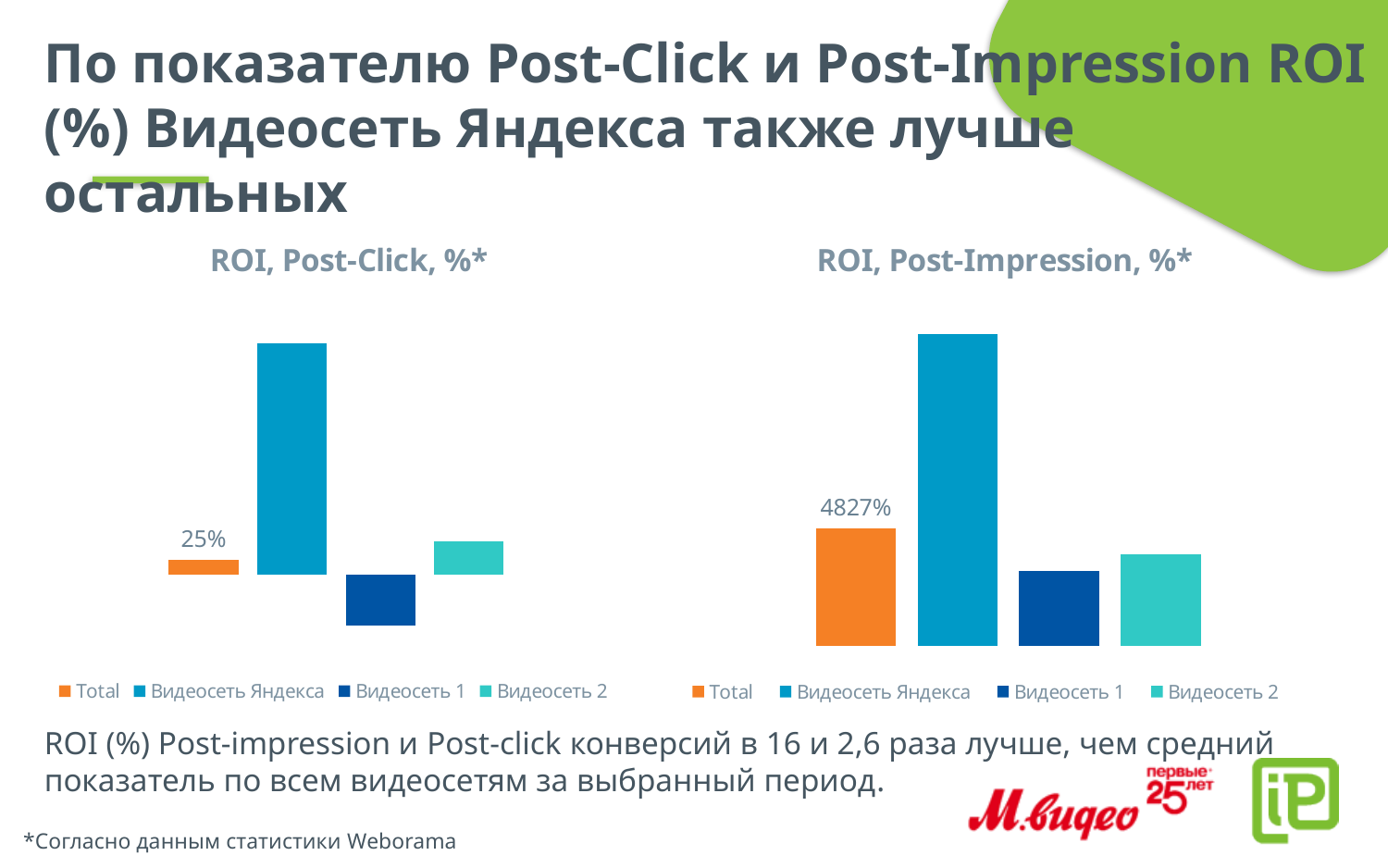
How many bars are plotted in the 'ROI, Post-Impression, %*' chart? 4 In the 'ROI, Post-Click, %*' chart, what is the value for Total? 25% In the 'ROI, Post-Impression, %*' chart, which is larger: Видеосеть 1 or Видеосеть 2? Видеосеть 2 In the 'ROI, Post-Impression, %*' chart, which series has the lowest value? Видеосеть 1 In the 'ROI, Post-Impression, %*' chart, which series has the highest value? Видеосеть Яндекса In the 'ROI, Post-Click, %*' chart, which series is shown in orange? Total How many series does the legend of the 'ROI, Post-Click, %*' chart list? 4 In the 'ROI, Post-Impression, %*' chart, what is the value for Total? 4827% In the 'ROI, Post-Click, %*' chart, which series has the highest value? Видеосеть Яндекса In the 'ROI, Post-Click, %*' chart, which series has the lowest value? Видеосеть 1 In the 'ROI, Post-Click, %*' chart, which is larger: Видеосеть 2 or Total? Видеосеть 2 What kind of chart is the 'ROI, Post-Impression, %*' chart? Bar chart